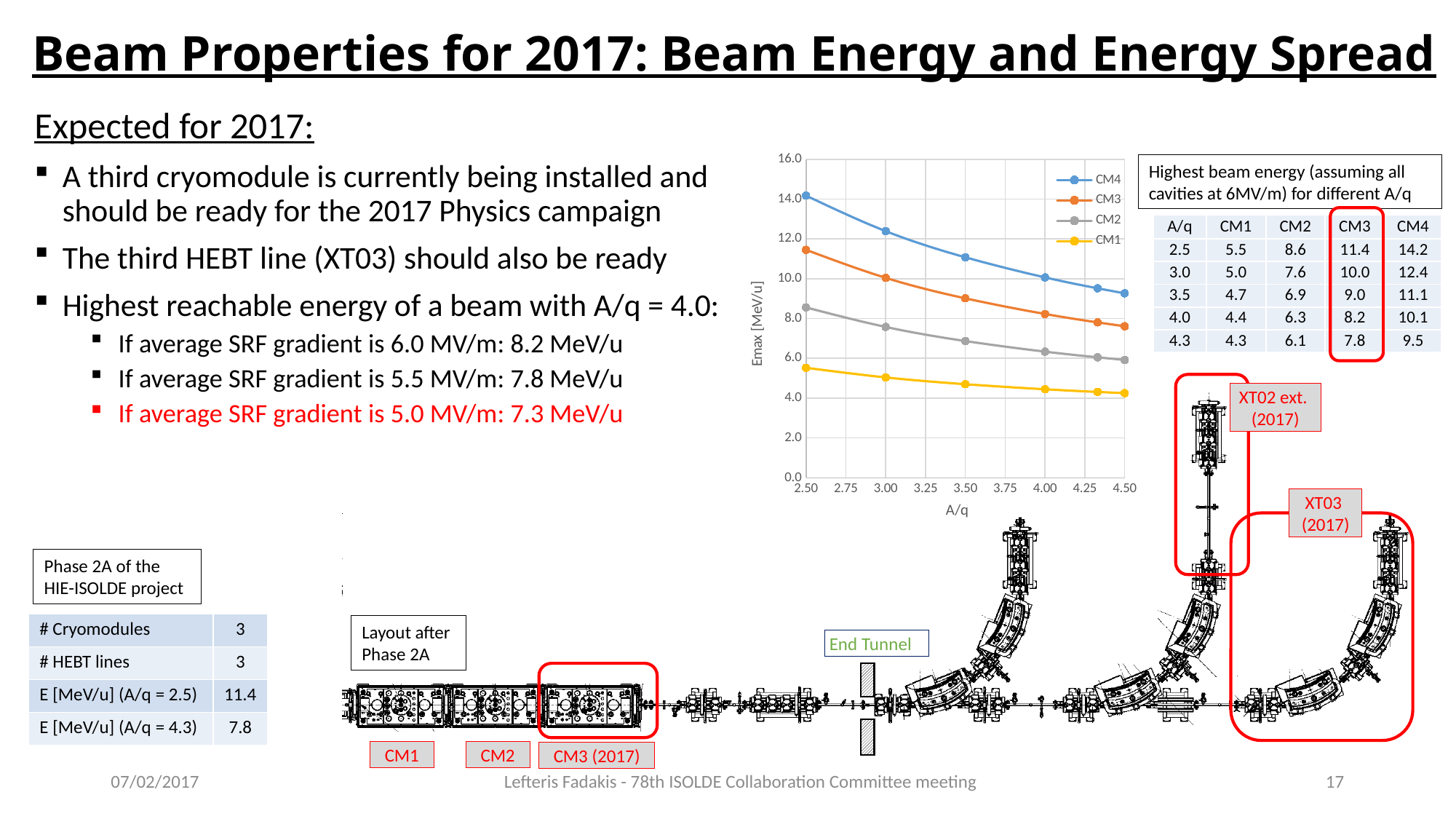
Do the Emax values rise or fall as A/q increases along the x axis? fall Is the CM2 value at A/q = 2.50 greater or less than 8.0? greater How many series does the chart legend list? 4 How many data points are plotted for each series in the chart? 6 What is the label of the chart's y axis? Emax [MeV/u] Which series has the highest Emax values across the chart? CM4 Is the CM1 value at A/q = 2.50 greater or less than 6.0? less Which series has the lowest Emax values across the chart? CM1 Is the CM3 value at A/q = 2.50 greater or less than 10.0? greater What kind of chart is shown on the slide? line chart At A/q = 3.00, which series has the larger value, CM3 or CM2? CM3